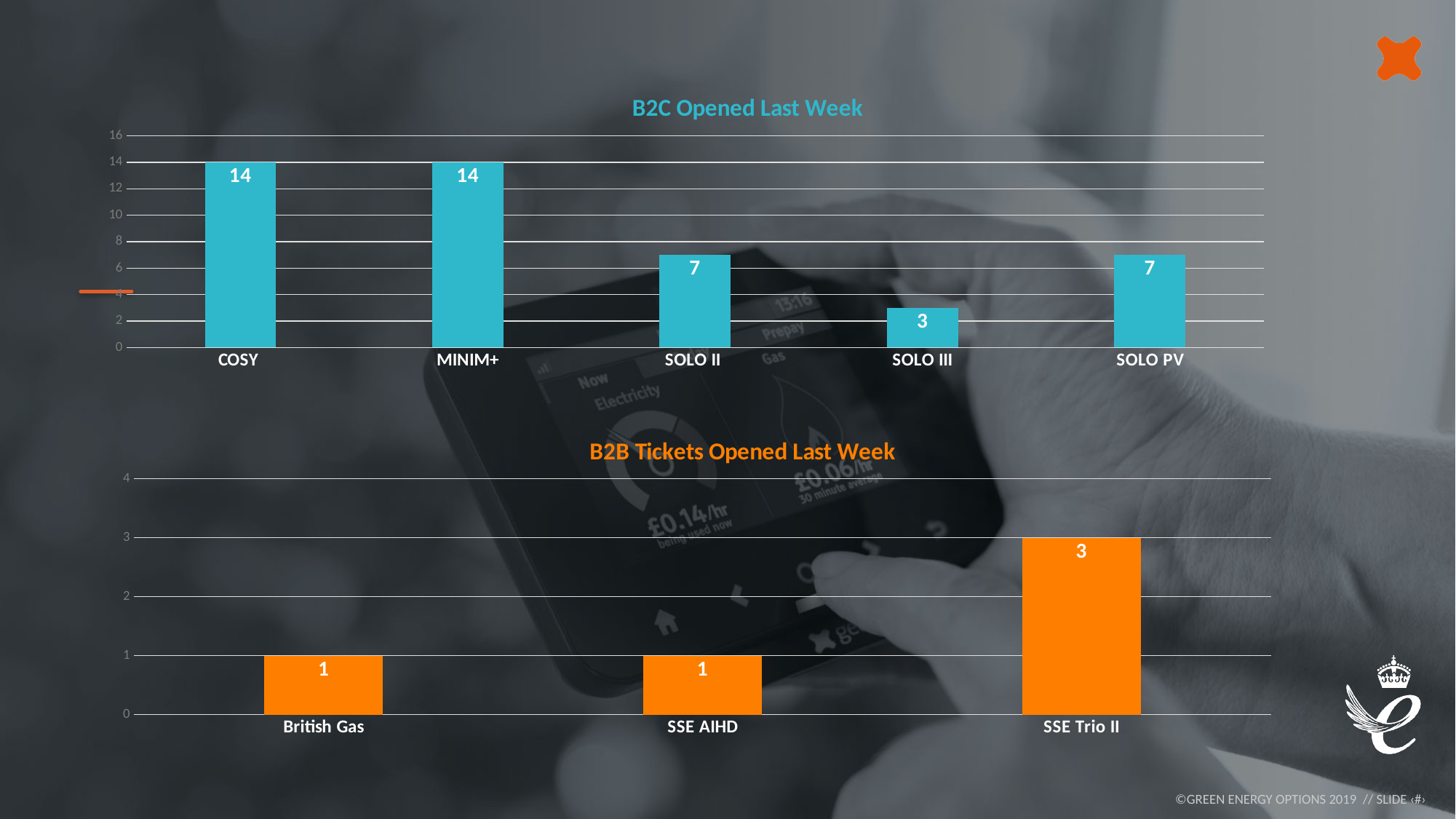
In the 'B2B Tickets Opened Last Week' chart, what is the difference between the values for SSE Trio II and British Gas? 2 In the 'B2C Opened Last Week' chart, what is the value for SOLO III? 3 In the 'B2C Opened Last Week' chart, which category has the lowest value? SOLO III How many categories are shown in the 'B2B Tickets Opened Last Week' chart? 3 How many categories are shown in the 'B2C Opened Last Week' chart? 5 In the 'B2C Opened Last Week' chart, which is larger, the value for MINIM+ or the value for SOLO II? MINIM+ In the 'B2C Opened Last Week' chart, what is the difference between the values for COSY and SOLO PV? 7 In the 'B2B Tickets Opened Last Week' chart, which category has the highest value? SSE Trio II What colour are the bars in the 'B2B Tickets Opened Last Week' chart? Orange What kind of chart is 'B2C Opened Last Week'? Bar chart In the 'B2C Opened Last Week' chart, what is the value for SOLO II? 7 In the 'B2B Tickets Opened Last Week' chart, what is the value for SSE Trio II? 3